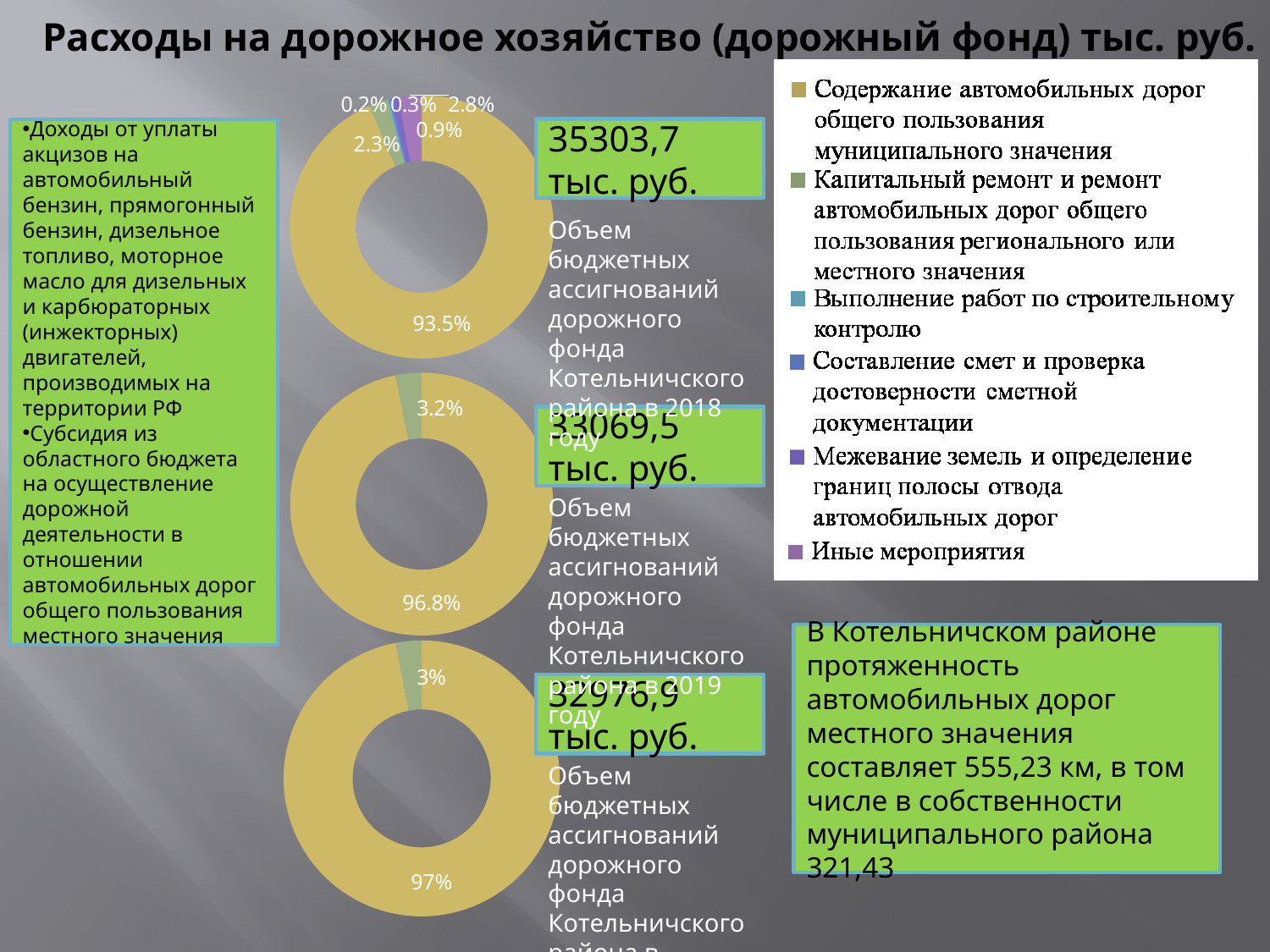
In the middle doughnut chart, what is the share of the smaller green slice? 3.2% In the bottom doughnut chart, what is the share of the largest slice? 97% In the top doughnut chart, what is the smallest labelled share? 0.2% In the middle doughnut chart, what share does the large yellow slice (Содержание автомобильных дорог общего пользования муниципального значения) have? 96.8% In the top doughnut chart, what is the share of the largest slice? 93.5% In the bottom doughnut chart, what is the share of the smaller slice? 3% In the bottom doughnut chart, what is the difference between the two slices (97% and 3%)? 94 percentage points What kind of chart is used on this slide to show the road fund expenditure shares? doughnut (pie) chart In the top doughnut chart, which is larger: the 2.3% slice or the 2.8% slice? the 2.8% slice How many entries does the legend on the right list? 6 Which legend entry is shown with the yellow colour that fills most of each doughnut? Содержание автомобильных дорог общего пользования муниципального значения How many labelled slices does the top doughnut chart have? 6